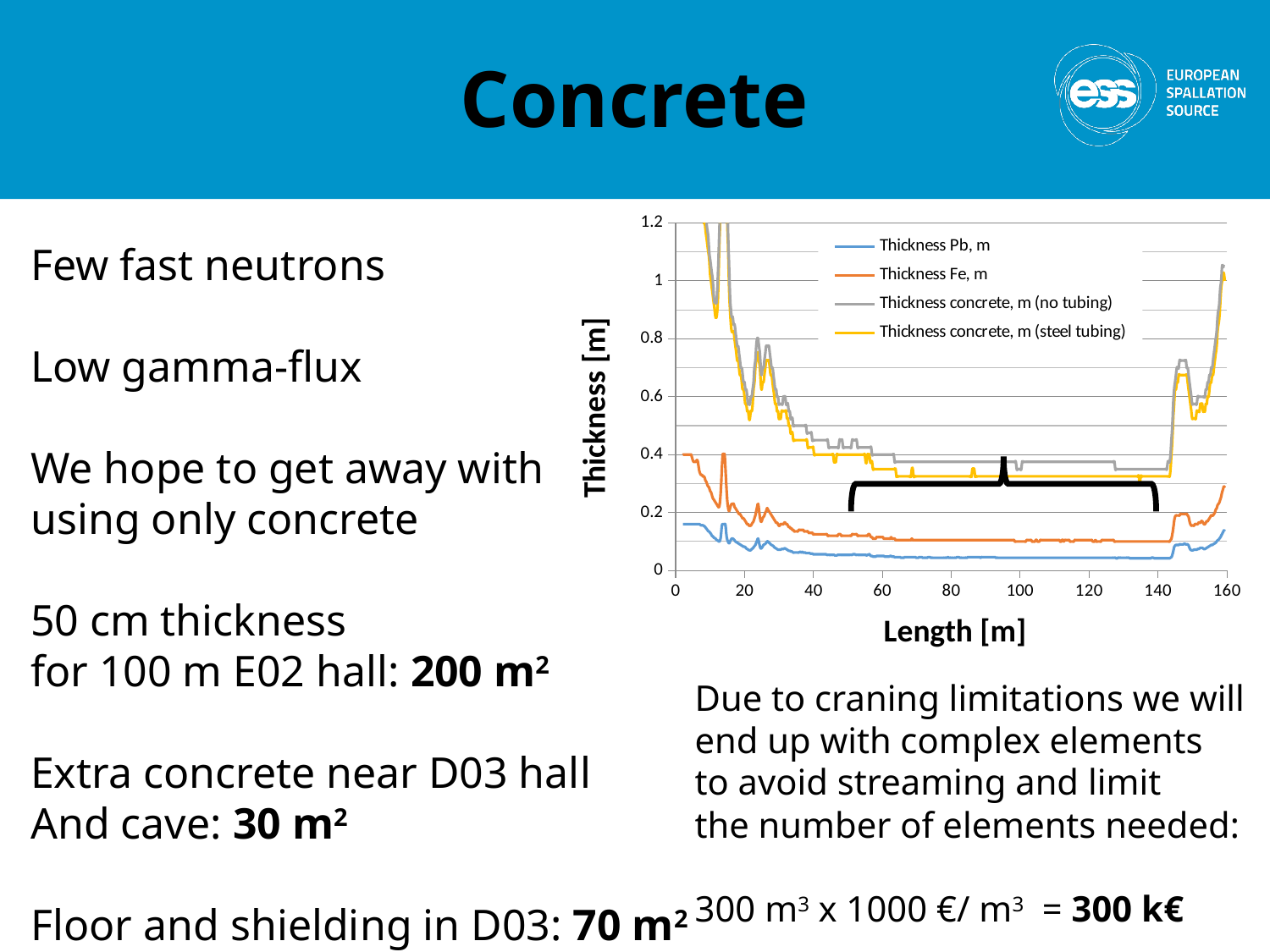
What is the title of the x axis of the chart? Length [m] Does the Thickness Pb, m series rise or fall as length increases from 0 m to 100 m? fall Is the value of Thickness concrete, m (no tubing) at a length of 160 m greater or less than 0.8? greater Which series has the lowest values across the whole length range? Thickness Pb, m What is the title of the y axis of the chart? Thickness [m] What kind of chart is shown on the slide? line chart How many series does the chart's legend list? 4 Is the value of Thickness Pb, m at a length of 100 m greater or less than 0.2? less Is the value of Thickness Fe, m at a length of 160 m greater or less than 0.4? less At a length of 60 m, which series has the larger value: Thickness concrete, m (no tubing) or Thickness Fe, m? Thickness concrete, m (no tubing) At a length of 100 m, which series has the larger value: Thickness Fe, m or Thickness Pb, m? Thickness Fe, m